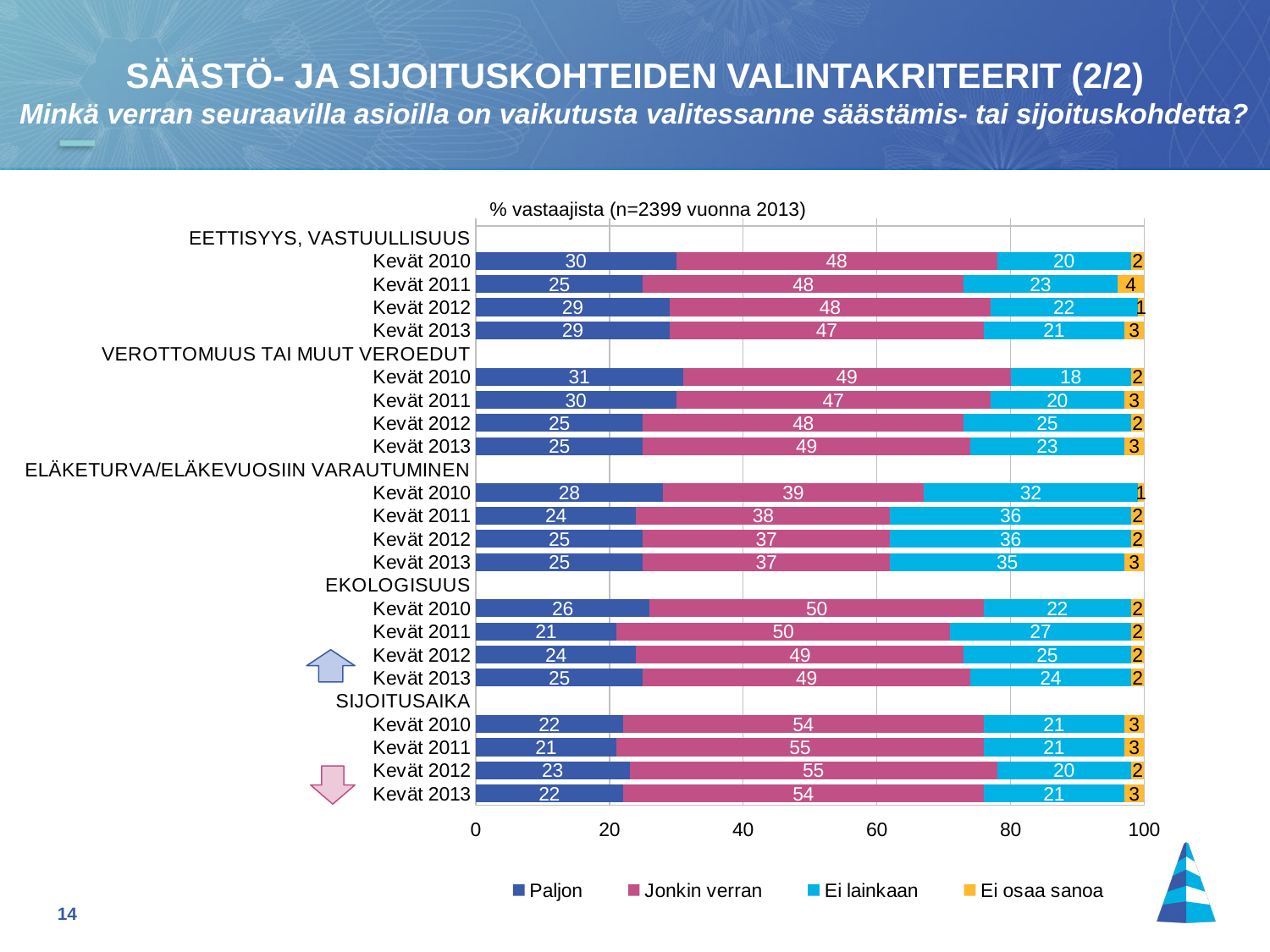
How many series does the legend list? 4 Which has the larger "Paljon" value for Kevät 2010: VEROTTOMUUS TAI MUUT VEROEDUT or EKOLOGISUUS? VEROTTOMUUS TAI MUUT VEROEDUT What kind of chart is shown on the slide? Stacked bar chart Among the Kevät 2010 rows, which criterion has the lowest "Jonkin verran" value? ELÄKETURVA/ELÄKEVUOSIIN VARAUTUMINEN What is the value of "Ei osaa sanoa" for Kevät 2011 under EETTISYYS, VASTUULLISUUS? 4 Does the "Paljon" value for VEROTTOMUUS TAI MUUT VEROEDUT rise or fall from Kevät 2010 to Kevät 2013? Fall What is the total of the stacked bar for Kevät 2013 under SIJOITUSAIKA? 100 What is the difference between the "Ei lainkaan" value for Kevät 2010 under ELÄKETURVA/ELÄKEVUOSIIN VARAUTUMINEN and the "Ei lainkaan" value for Kevät 2010 under EETTISYYS, VASTUULLISUUS? 12 What is the value of "Ei lainkaan" for Kevät 2012 under ELÄKETURVA/ELÄKEVUOSIIN VARAUTUMINEN? 36 What is the value of "Jonkin verran" for Kevät 2011 under SIJOITUSAIKA? 55 What is the value of "Paljon" for Kevät 2013 under EETTISYYS, VASTUULLISUUS? 29 Among the Kevät 2013 rows, which criterion has the highest "Paljon" value? EETTISYYS, VASTUULLISUUS